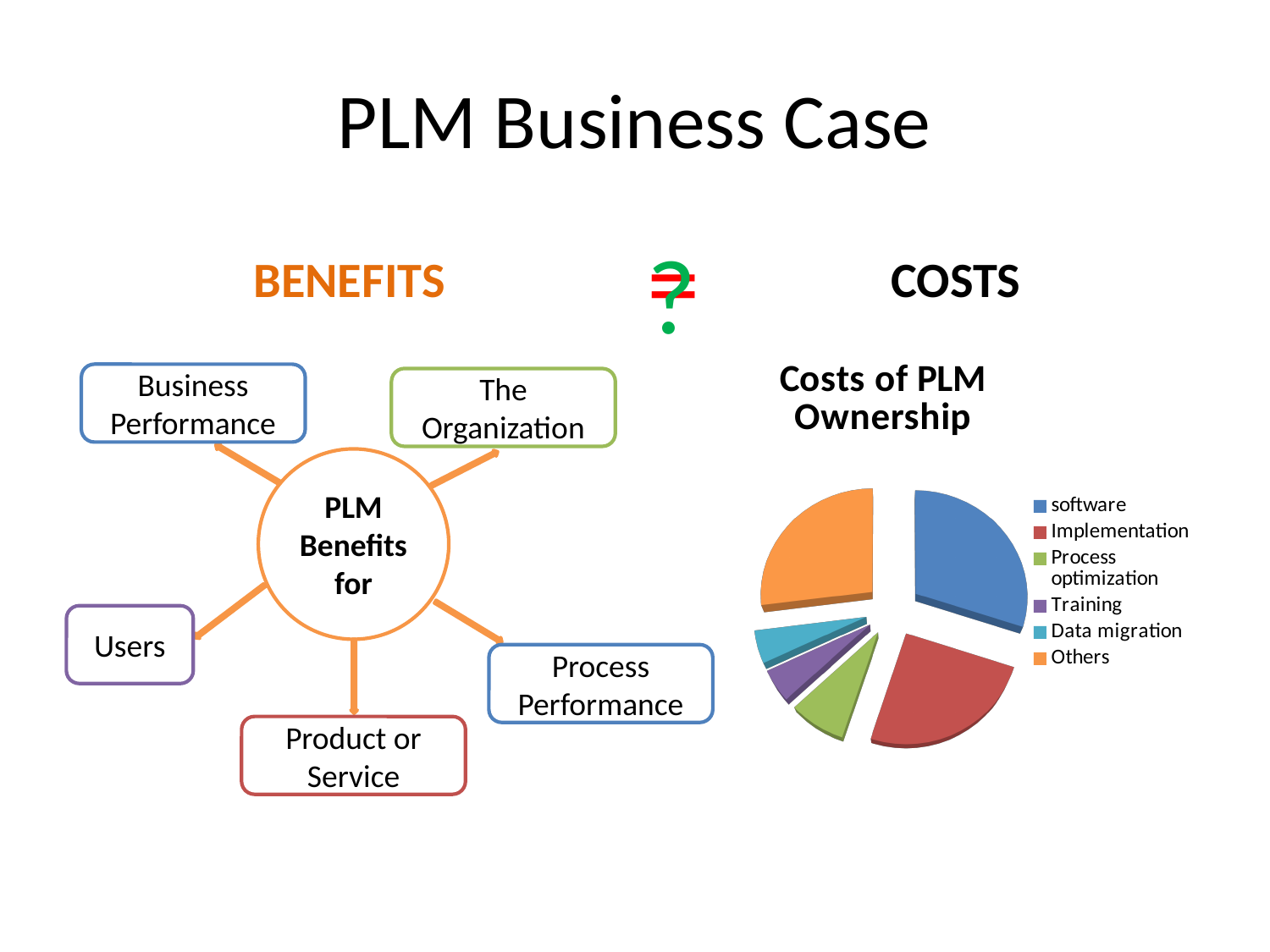
Which legend entry is listed first in the Costs of PLM Ownership pie chart? software In the Costs of PLM Ownership pie chart, which slice is larger: Process optimization or Training? Process optimization What kind of chart is shown under the COSTS heading? pie chart In the Costs of PLM Ownership pie chart, which slice is larger: Others or Data migration? Others Which colour represents Implementation in the Costs of PLM Ownership pie chart? red In the Costs of PLM Ownership pie chart, which slice is larger: software or Training? software How many categories does the legend of the Costs of PLM Ownership pie chart list? 6 What is the title of the pie chart on the slide? Costs of PLM Ownership